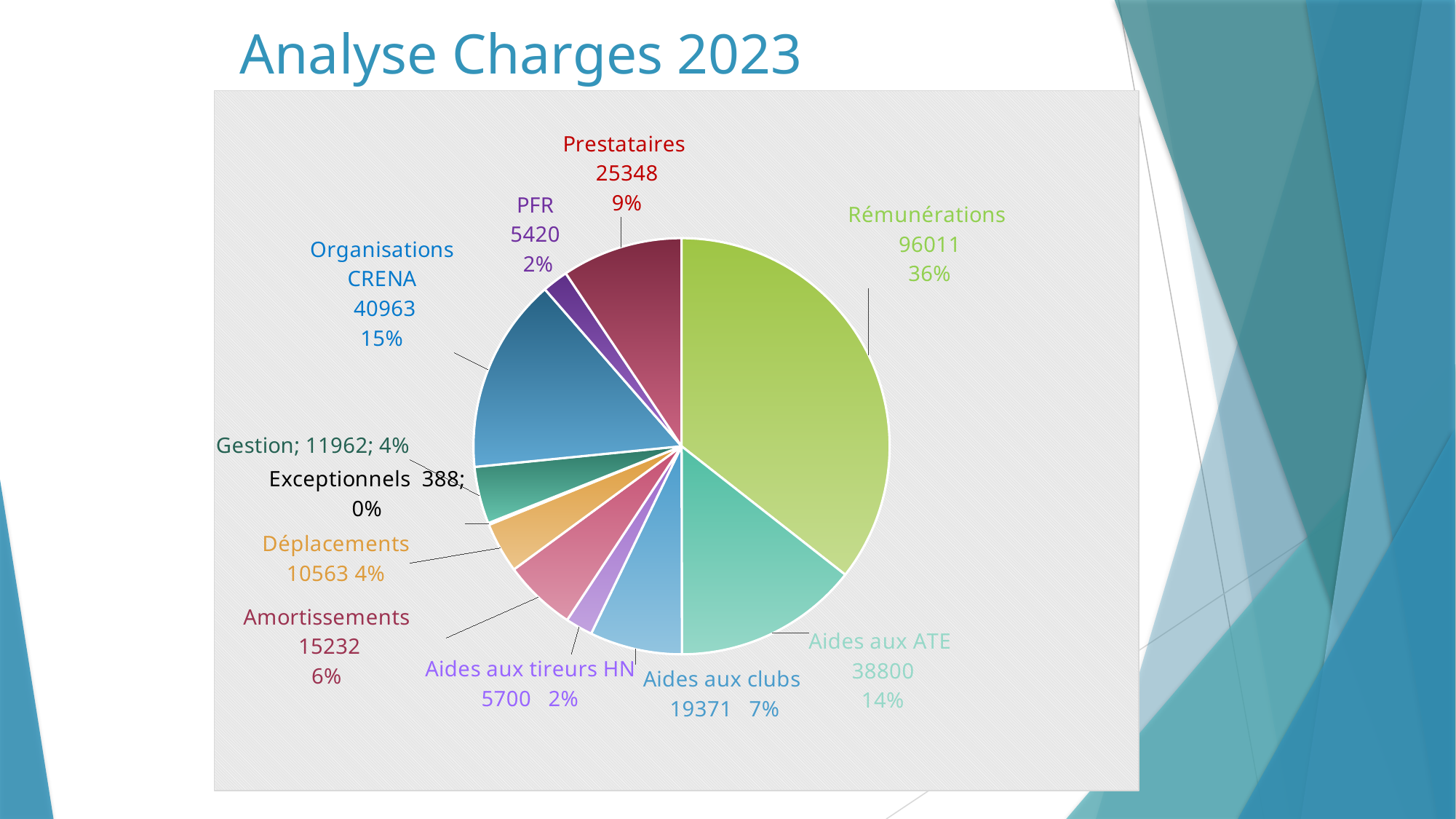
Which is larger, the value for Aides aux clubs or the value for Amortissements? Aides aux clubs Which category has the smallest slice of the pie? Exceptionnels What is the value for Aides aux ATE? 38800 What share of the pie does Aides aux ATE represent? 14% What share of the pie does Prestataires represent? 9% What is the value for Amortissements? 15232 What kind of chart is shown on the slide? pie chart What is the difference between the values for Organisations CRENA and Aides aux ATE? 2163 What is the value for Organisations CRENA? 40963 Which category has the largest slice of the pie? Rémunérations How many categories are shown in the pie chart? 11 What is the value for Rémunérations? 96011